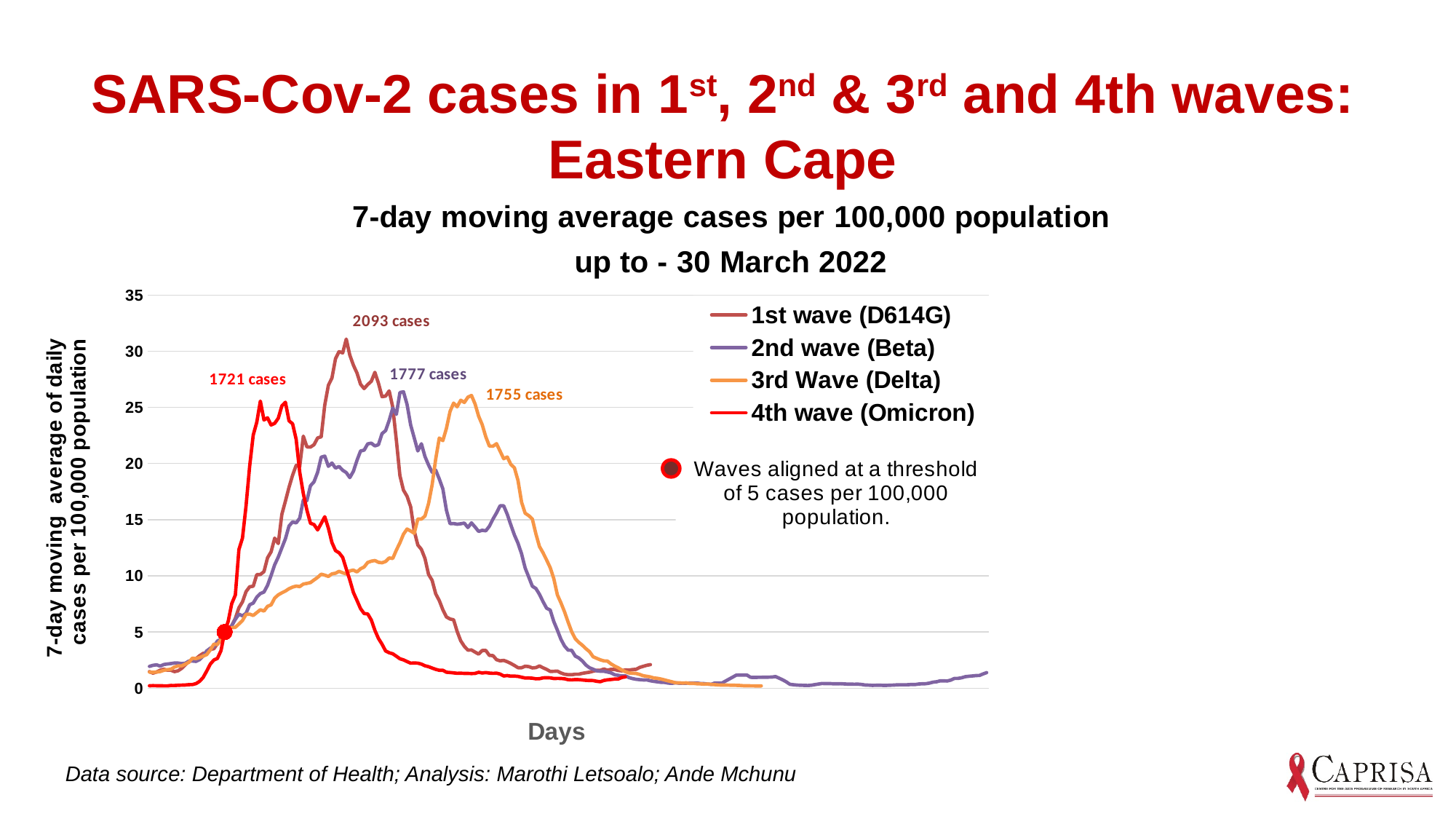
Which wave has the highest labelled peak case count? 1st wave (D614G) Which has a larger labelled peak case count, the 2nd wave (Beta) or the 3rd Wave (Delta)? 2nd wave (Beta) Is the peak 7-day moving average for the 4th wave (Omicron) greater or less than 20? greater At what threshold of cases per 100,000 population are the waves aligned? 5 cases per 100,000 population What kind of chart is shown on the slide? line chart What is the difference between the labelled peak case counts of the 1st wave (2093 cases) and the 4th wave (1721 cases)? 372 How many cases are labelled at the peak of the 1st wave (D614G)? 2093 cases How many cases are labelled at the peak of the 4th wave (Omicron)? 1721 cases How many series does the legend list? 4 How many cases are labelled at the peak of the 3rd Wave (Delta)? 1755 cases How many cases are labelled at the peak of the 2nd wave (Beta)? 1777 cases Which wave has the lowest labelled peak case count? 4th wave (Omicron)